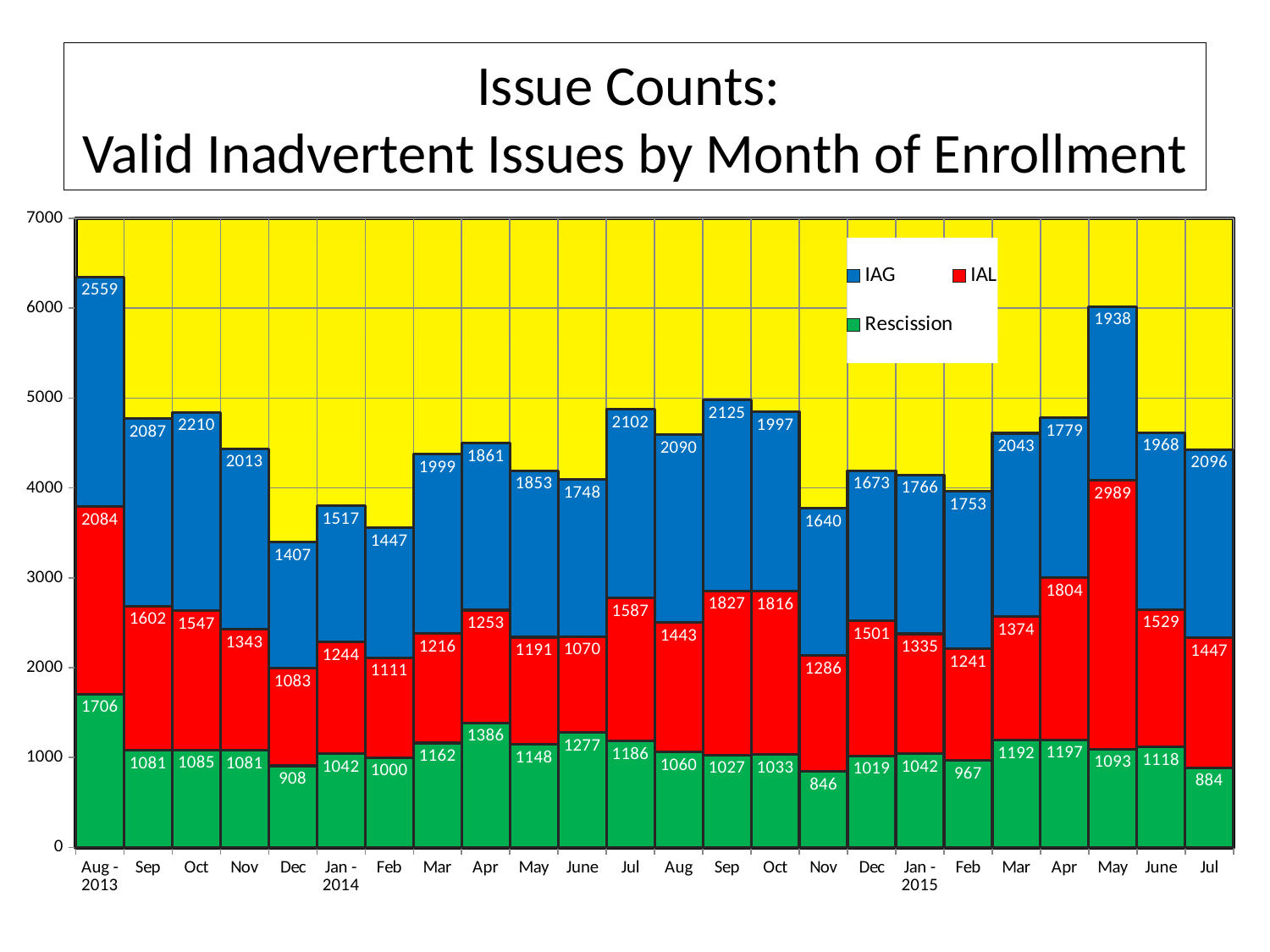
Which month has the highest IAL value? May 2015 What is the IAG value for Aug 2013? 2559 What is the difference between the IAG values for Sep 2014 and Oct 2014? 128 How many months are plotted along the x axis? 24 Which month has the lowest Rescission value? Nov 2014 What is the Rescission value for Apr 2014? 1386 What is the total of the stacked bar for Dec 2013? 3398 Which is larger, the IAL value for Jul 2014 or the IAL value for Aug 2014? Jul 2014 How many series does the legend list? 3 What is the IAL value for May 2015? 2989 What kind of chart is shown on the slide? stacked bar chart Which series is shown in green? Rescission